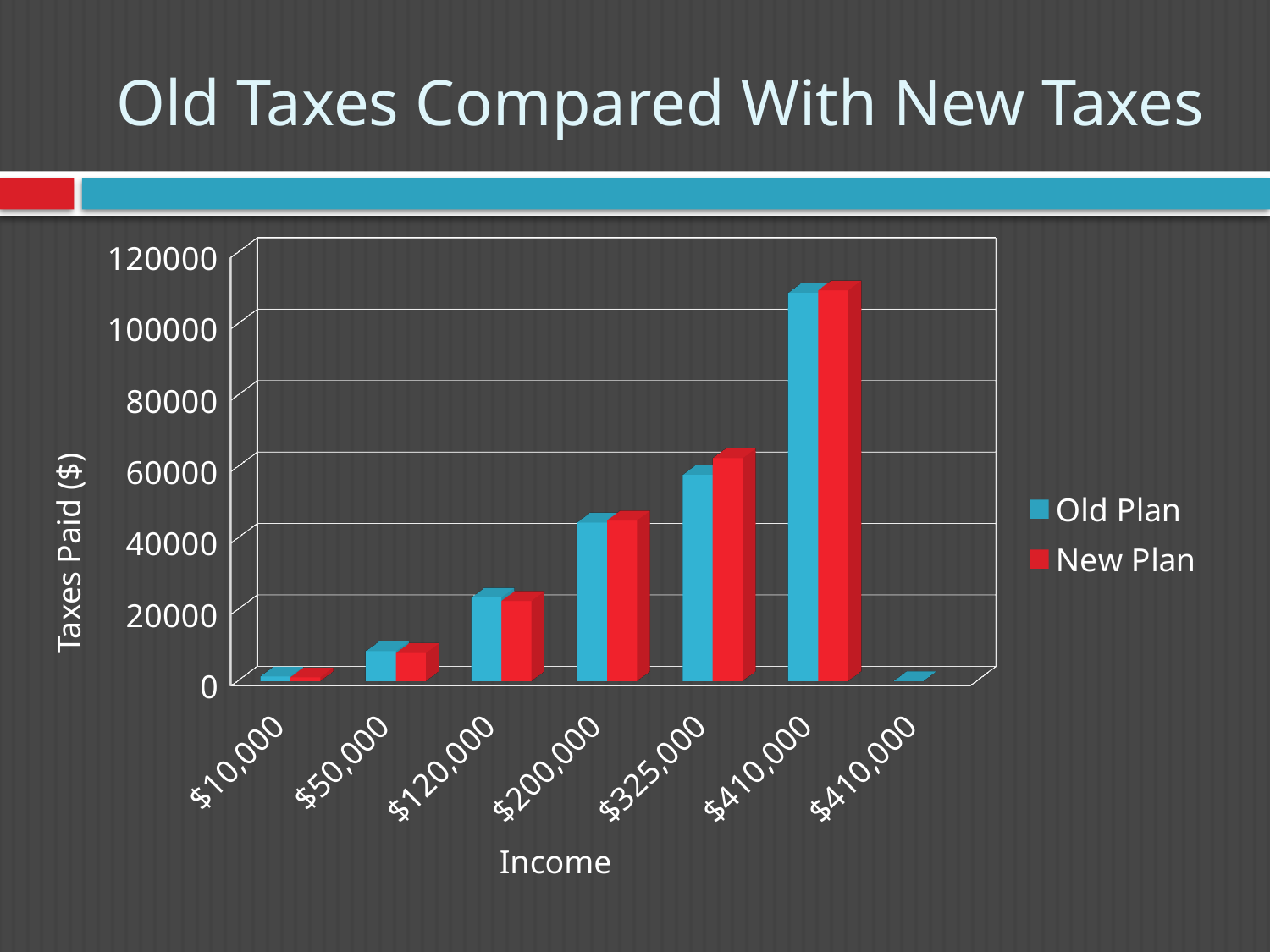
How many income categories are shown along the x axis? 7 Is the Old Plan value for $410,000 income greater or less than 100000? greater How many series does the legend list? 2 What kind of chart is shown on the slide? bar chart Is the New Plan value for $50,000 income greater or less than 20000? less Is the Old Plan value for $200,000 income greater or less than 40000? greater What is the title of the chart's vertical axis? Taxes Paid ($) At $325,000 income, which plan shows higher taxes paid, Old Plan or New Plan? New Plan Which income level has the highest Old Plan taxes paid? $410,000 Which colour represents the New Plan series in the legend? red Do the taxes paid generally rise or fall as income increases from $10,000 to $410,000? rise